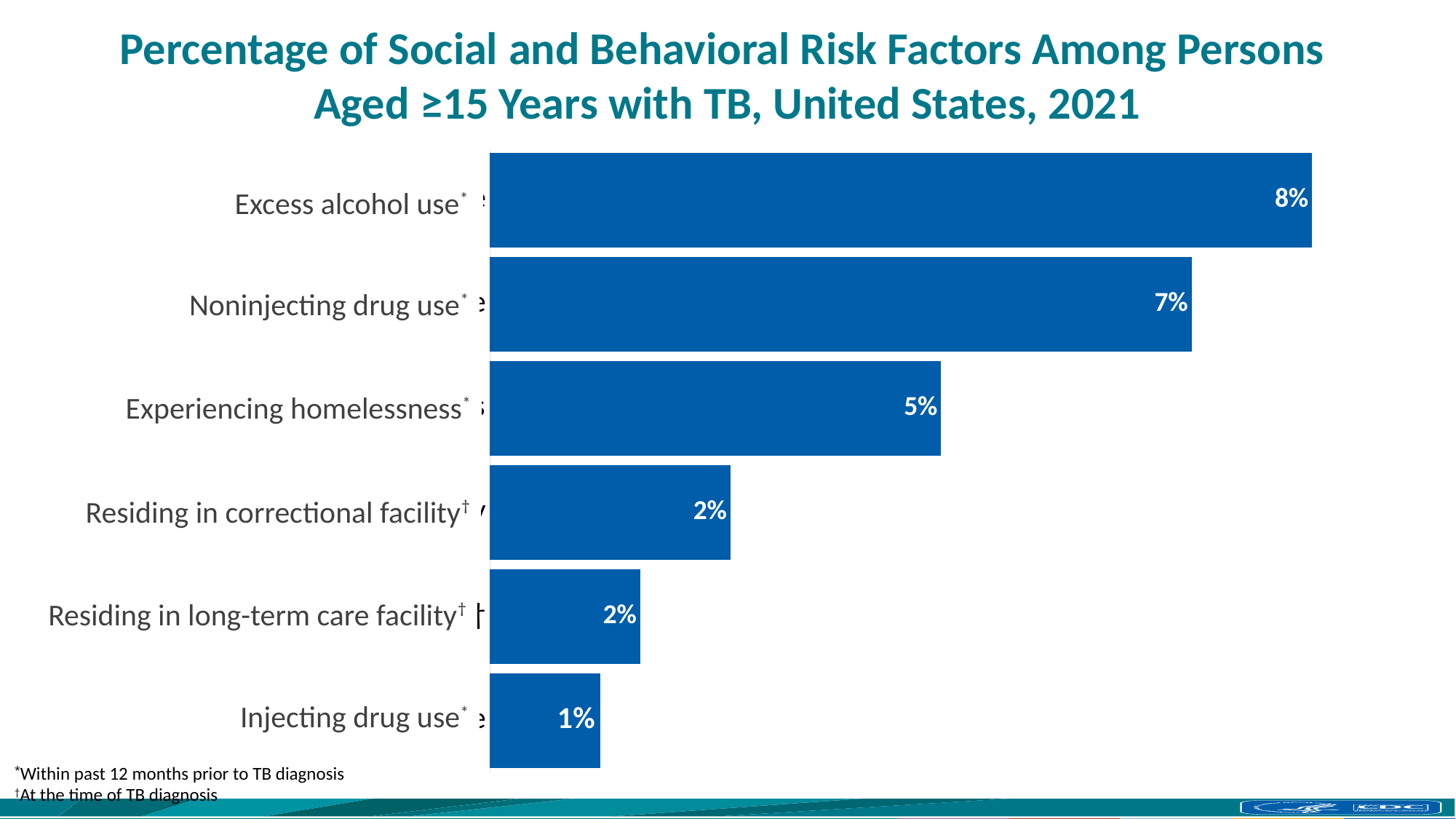
How many risk factor categories are shown in the chart? 6 What is the percentage for Injecting drug use? 1% Which risk factor has the lowest percentage? Injecting drug use What is the percentage for Noninjecting drug use? 7% What is the difference between the percentages for Noninjecting drug use and Injecting drug use? 6% What kind of chart is shown on the slide? Bar chart Which risk factor has the highest percentage? Excess alcohol use What is the percentage for Experiencing homelessness? 5% According to the footnote, what does the asterisk (*) on a category label mean? Within past 12 months prior to TB diagnosis What is the percentage for Excess alcohol use? 8% What is the difference between the percentages for Excess alcohol use and Experiencing homelessness? 3% Which is larger, the percentage for Experiencing homelessness or for Residing in correctional facility? Experiencing homelessness